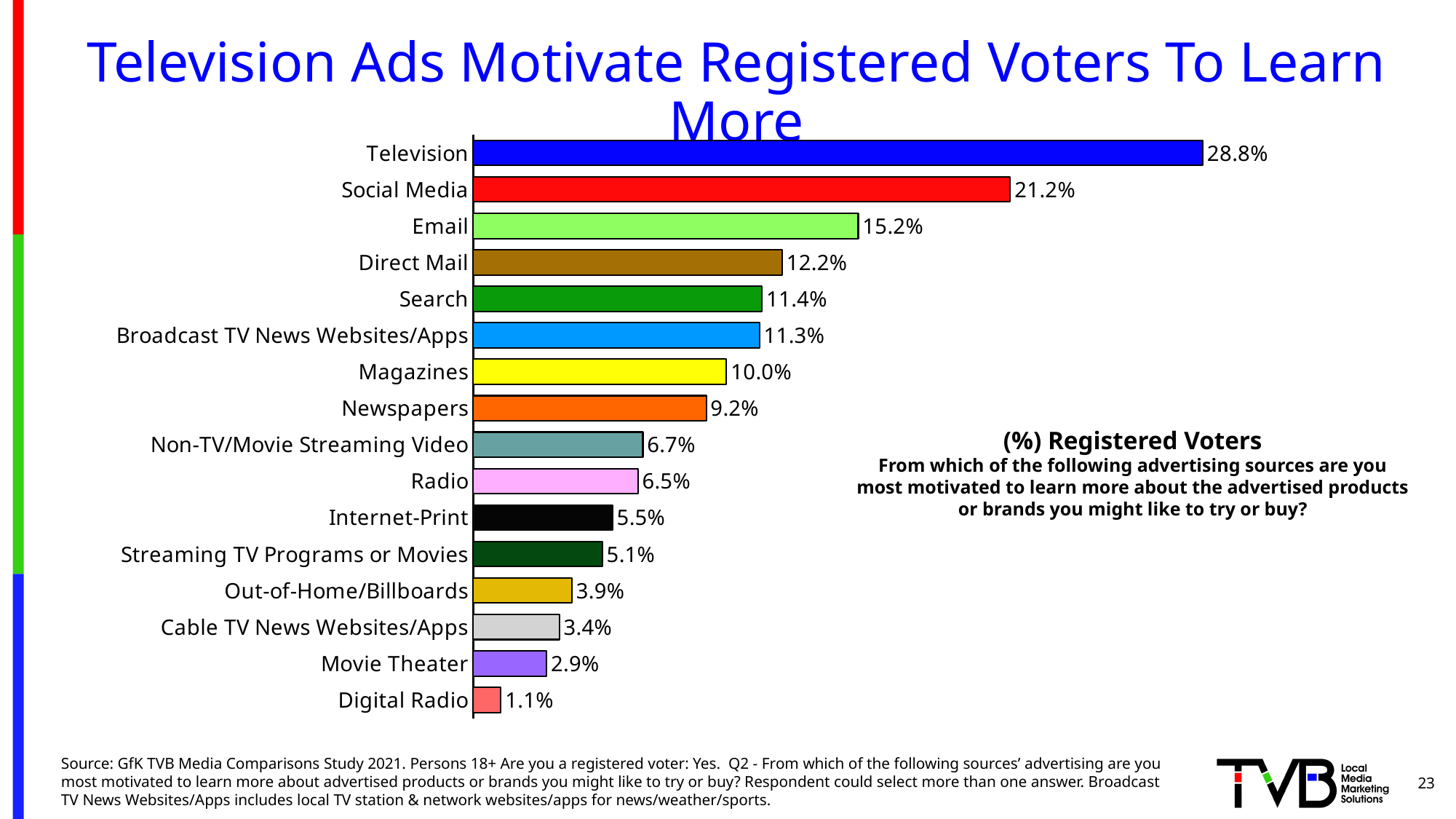
What is the value shown for Radio? 6.5% How many advertising sources are shown in the chart? 16 What percentage of registered voters are most motivated by Television ads to learn more? 28.8% Which advertising source has the lowest percentage? Digital Radio What is the difference between the values for Television and Social Media? 7.6% Which advertising source has the highest percentage? Television What colour is the bar for Television? Blue What is the value shown for Direct Mail? 12.2% What is the value shown for Social Media? 21.2% What type of chart is shown on the slide? Bar chart What is the difference between the values for Email and Newspapers? 6.0% Which has a larger value, Magazines or Newspapers? Magazines